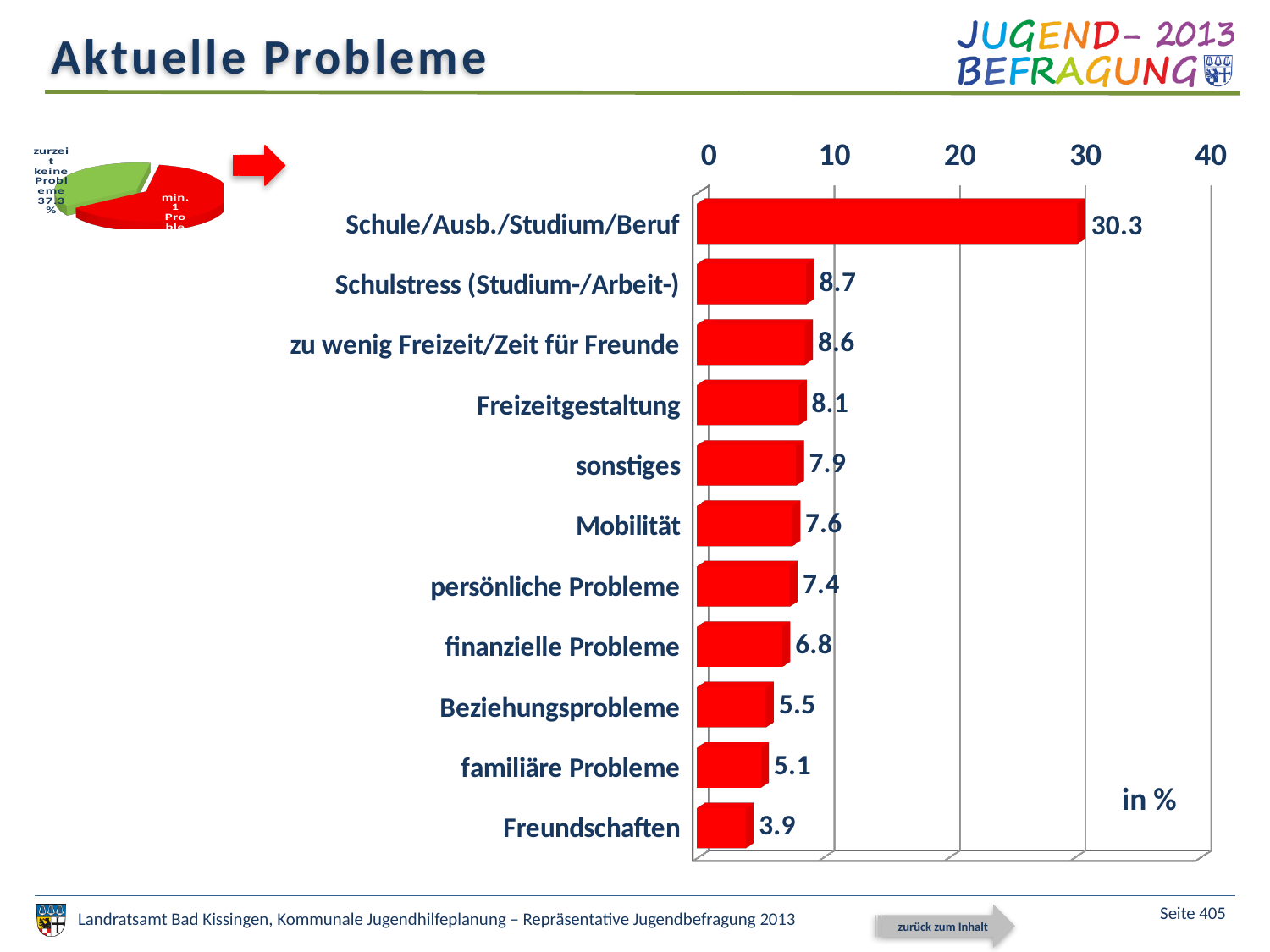
In the bar chart, what is the difference between the values for Schule/Ausb./Studium/Beruf and Schulstress (Studium-/Arbeit-)? 21.6 In the bar chart, which is larger: the value for Freizeitgestaltung or the value for persönliche Probleme? Freizeitgestaltung In the bar chart, what is the value for Mobilität? 7.6 In the bar chart, which category has the lowest value? Freundschaften How many categories does the bar chart show? 11 In the bar chart, what is the value for finanzielle Probleme? 6.8 In the bar chart, what is the value for Schule/Ausb./Studium/Beruf? 30.3 In the bar chart, what is the difference between the values for Beziehungsprobleme and Freundschaften? 1.6 In the bar chart, what is the value for familiäre Probleme? 5.1 What kind of chart is the large chart on the right side of the slide? bar chart In the bar chart, which category has the highest value? Schule/Ausb./Studium/Beruf In the bar chart, is the value for sonstiges greater or less than 10? less